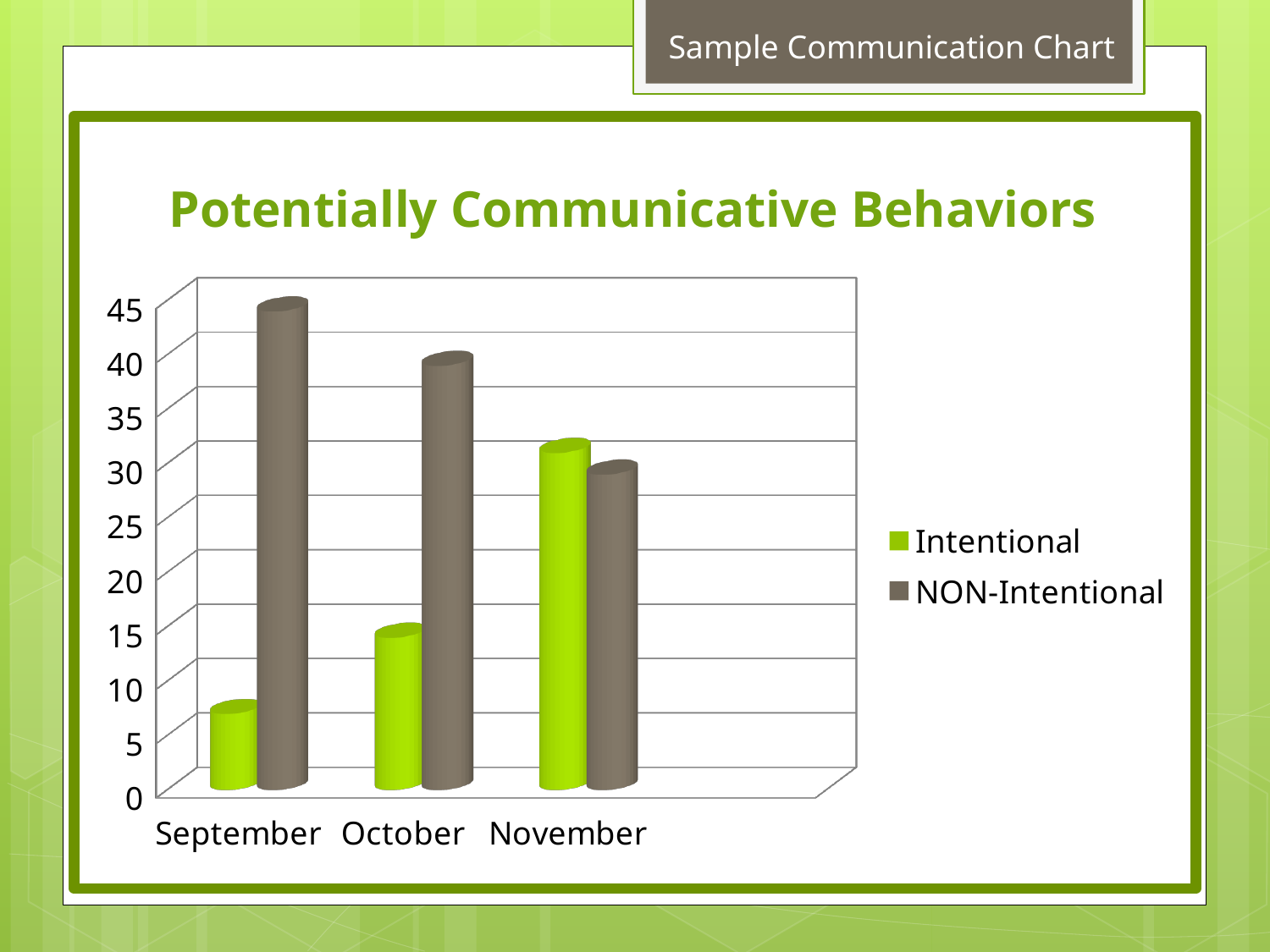
Is the Intentional value for October greater or less than 20? less Which month has the lowest Intentional value? September What kind of chart is shown on the slide? bar chart In September, which is larger, the Intentional or the NON-Intentional value? NON-Intentional Do the NON-Intentional values rise or fall from September to November? fall Is the NON-Intentional value for September greater or less than 40? greater Do the Intentional values rise or fall from September to November? rise How many months are shown on the x axis? 3 Is the Intentional value for November greater or less than 25? greater How many series does the legend list? 2 Which month has the highest NON-Intentional value? September What is the title of the chart? Potentially Communicative Behaviors